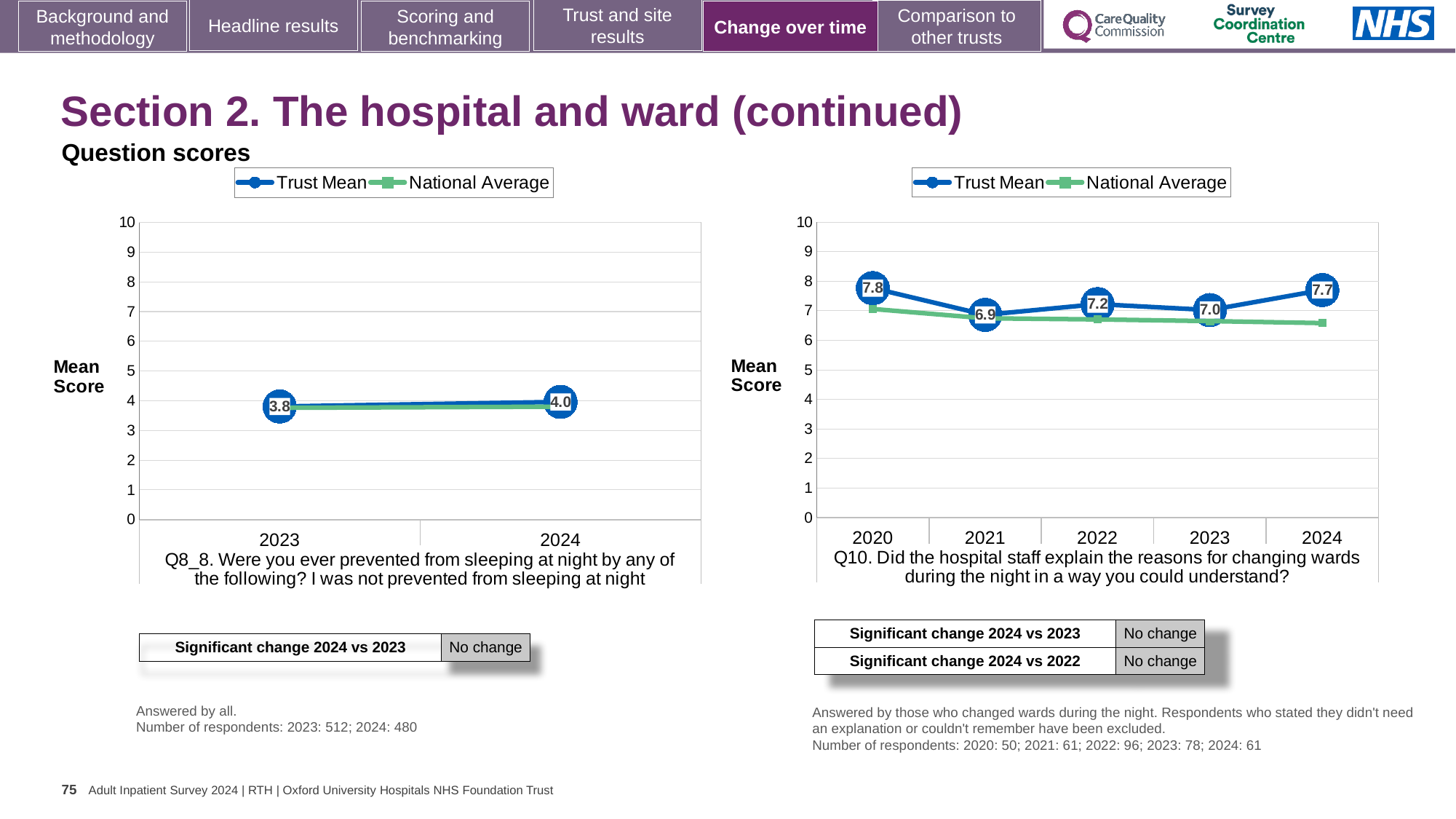
In the right chart (Q10), which year has the lowest Trust Mean? 2021 In the right chart (Q10), what is the Trust Mean for 2022? 7.2 In the right chart (Q10), which year has the highest Trust Mean? 2020 In the right chart (Q10), is the Trust Mean for 2021 greater or less than the Trust Mean for 2024? less How many years are plotted on the x axis of the right chart (Q10)? 5 In the right chart (Q10), what is the Trust Mean for 2020? 7.8 How many series does the legend of the left chart (Q8_8) list? 2 In the right chart (Q10), is the National Average for 2024 greater or less than 7? less In the left chart (Q8_8), what is the difference between the Trust Mean in 2024 and in 2023? 0.2 In the left chart (Q8_8), what is the Trust Mean for 2024? 4.0 In the left chart (Q8_8), what is the Trust Mean for 2023? 3.8 In the right chart (Q10), what is the difference between the Trust Mean in 2024 and in 2023? 0.7